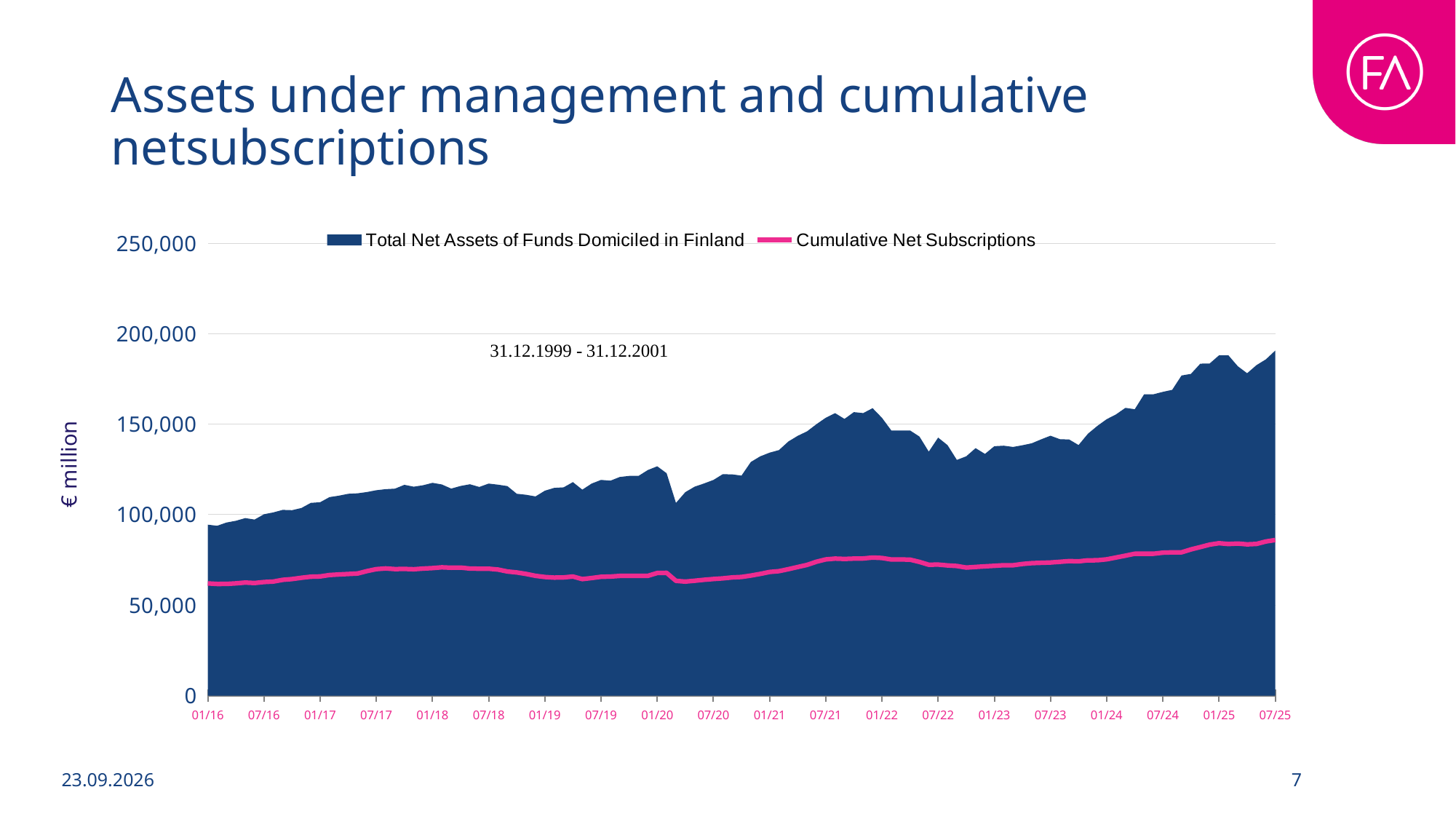
At 07/25, which is larger: Total Net Assets of Funds Domiciled in Finland or Cumulative Net Subscriptions? Total Net Assets of Funds Domiciled in Finland What are the two series named in the legend? Total Net Assets of Funds Domiciled in Finland; Cumulative Net Subscriptions Is the value of Cumulative Net Subscriptions at 07/25 greater or less than 100,000? less At which x-axis label is Total Net Assets of Funds Domiciled in Finland at its lowest? 01/16 Is the value of Cumulative Net Subscriptions at 01/16 greater or less than 50,000? greater Is the value of Total Net Assets of Funds Domiciled in Finland at 07/25 greater or less than 150,000? greater What is the label on the vertical axis? € million Do the values of Total Net Assets of Funds Domiciled in Finland generally rise or fall from 01/16 to 07/25? Rise How many series does the legend list? 2 How many date labels are shown on the x axis? 20 What kind of chart is shown on the slide? An area chart with a line series